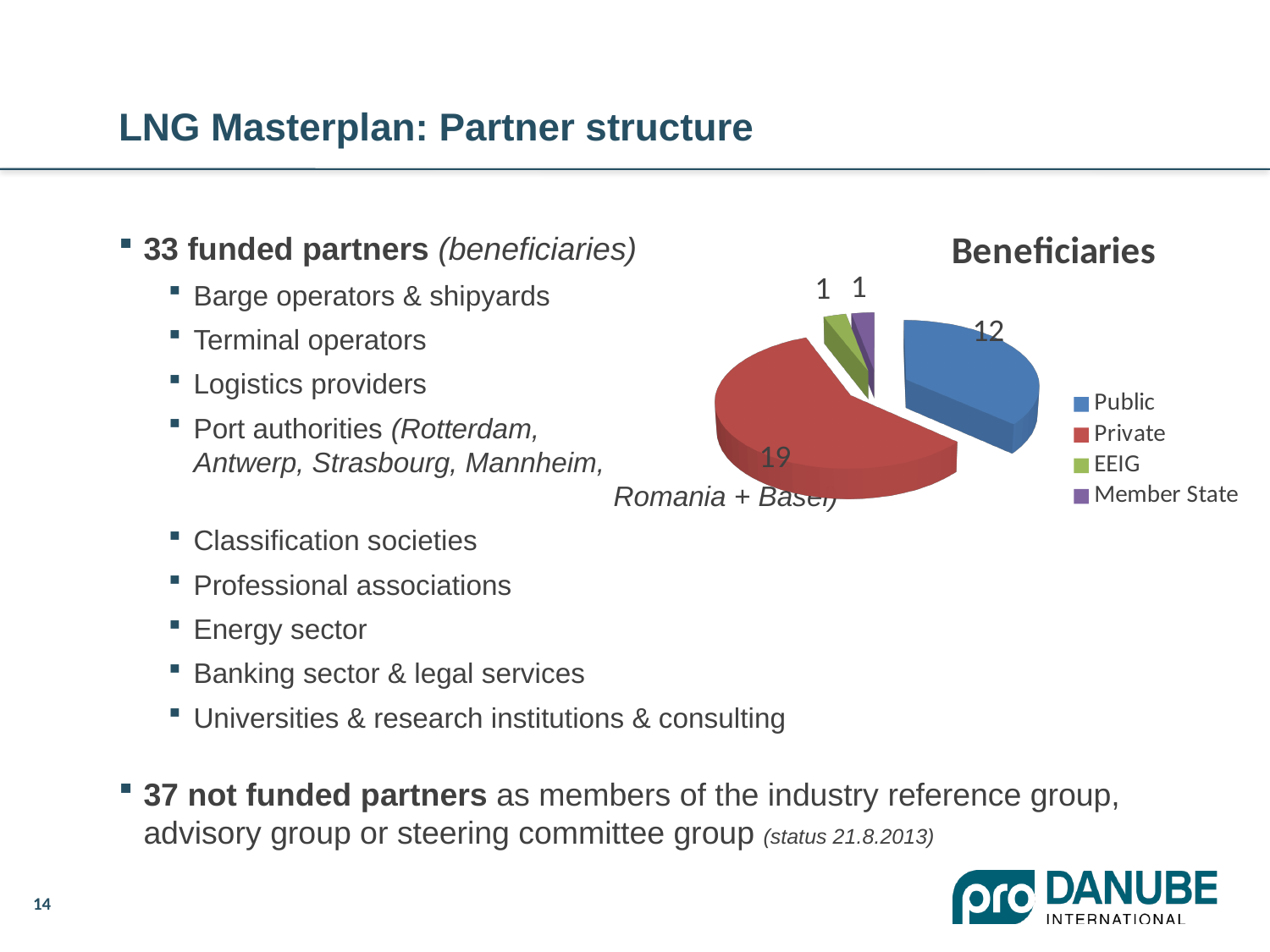
What is the value for Private in the Beneficiaries chart? 19 What is the difference between the Public and Member State values in the Beneficiaries chart? 11 Which is larger in the Beneficiaries chart, Public or Private? Private What is the total of all slices in the Beneficiaries chart? 33 What is the value for Public in the Beneficiaries chart? 12 How many categories does the Beneficiaries pie chart show? 4 What is the title of the pie chart? Beneficiaries Which colour represents Member State in the Beneficiaries chart legend? purple Which category has the largest slice in the Beneficiaries chart? Private What is the difference between the Private and Public values in the Beneficiaries chart? 7 What is the value for EEIG in the Beneficiaries chart? 1 What kind of chart is shown on the slide? pie chart